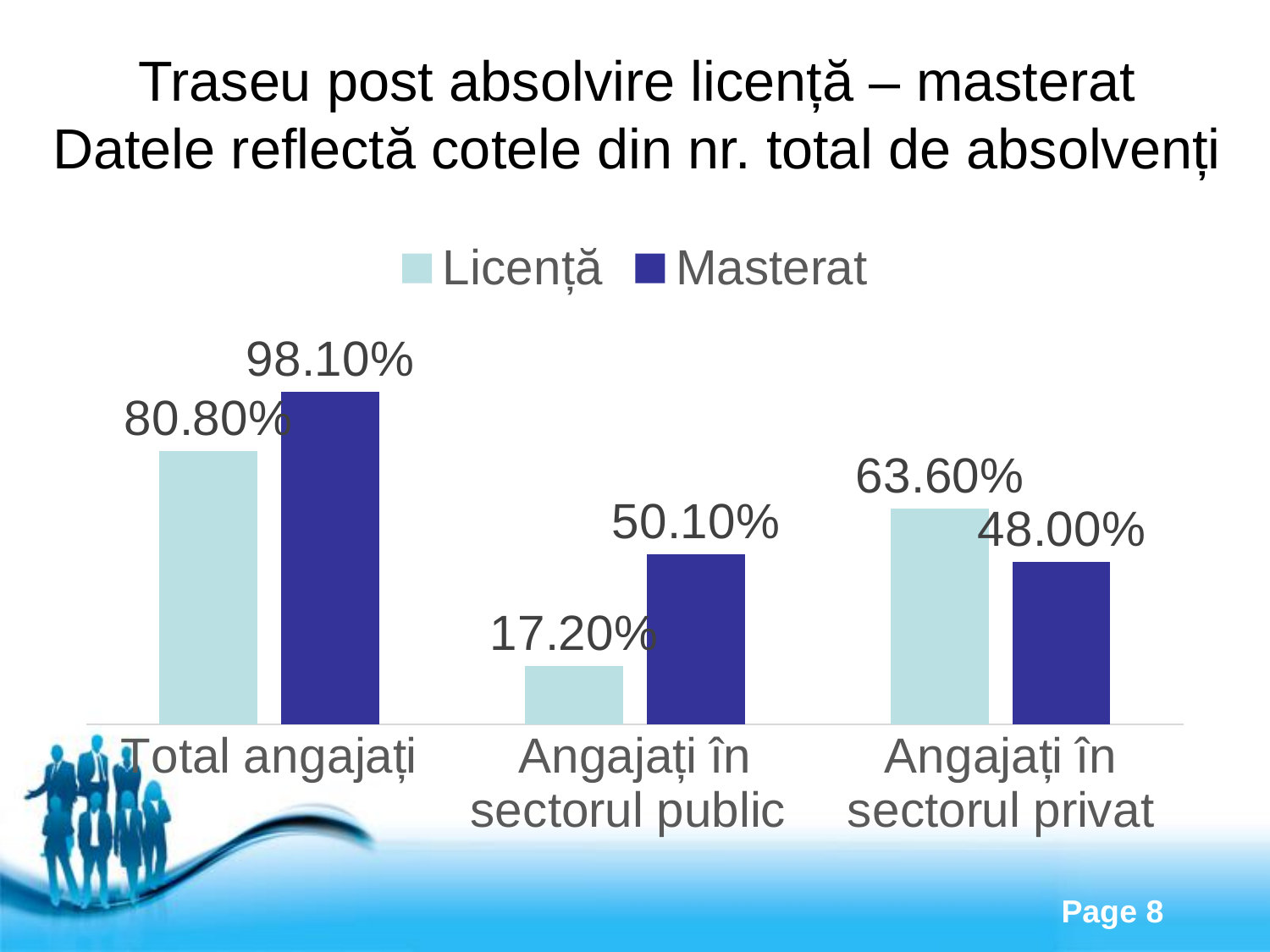
How many series does the legend list? 2 What is the Licență value for Angajați în sectorul privat? 63.60% What is the difference between the Masterat and Licență values for Total angajați? 17.30% What is the Licență value for Angajați în sectorul public? 17.20% What is the Masterat value for Angajați în sectorul public? 50.10% Which category has the highest Licență value? Total angajați What is the difference between the Masterat and Licență values for Angajați în sectorul public? 32.90% What is the Masterat value for Total angajați? 98.10% How many categories are shown on the x axis? 3 What kind of chart is shown on the slide? Bar chart Which category has the lowest Masterat value? Angajați în sectorul privat For Angajați în sectorul privat, which series has the larger value, Licență or Masterat? Licență